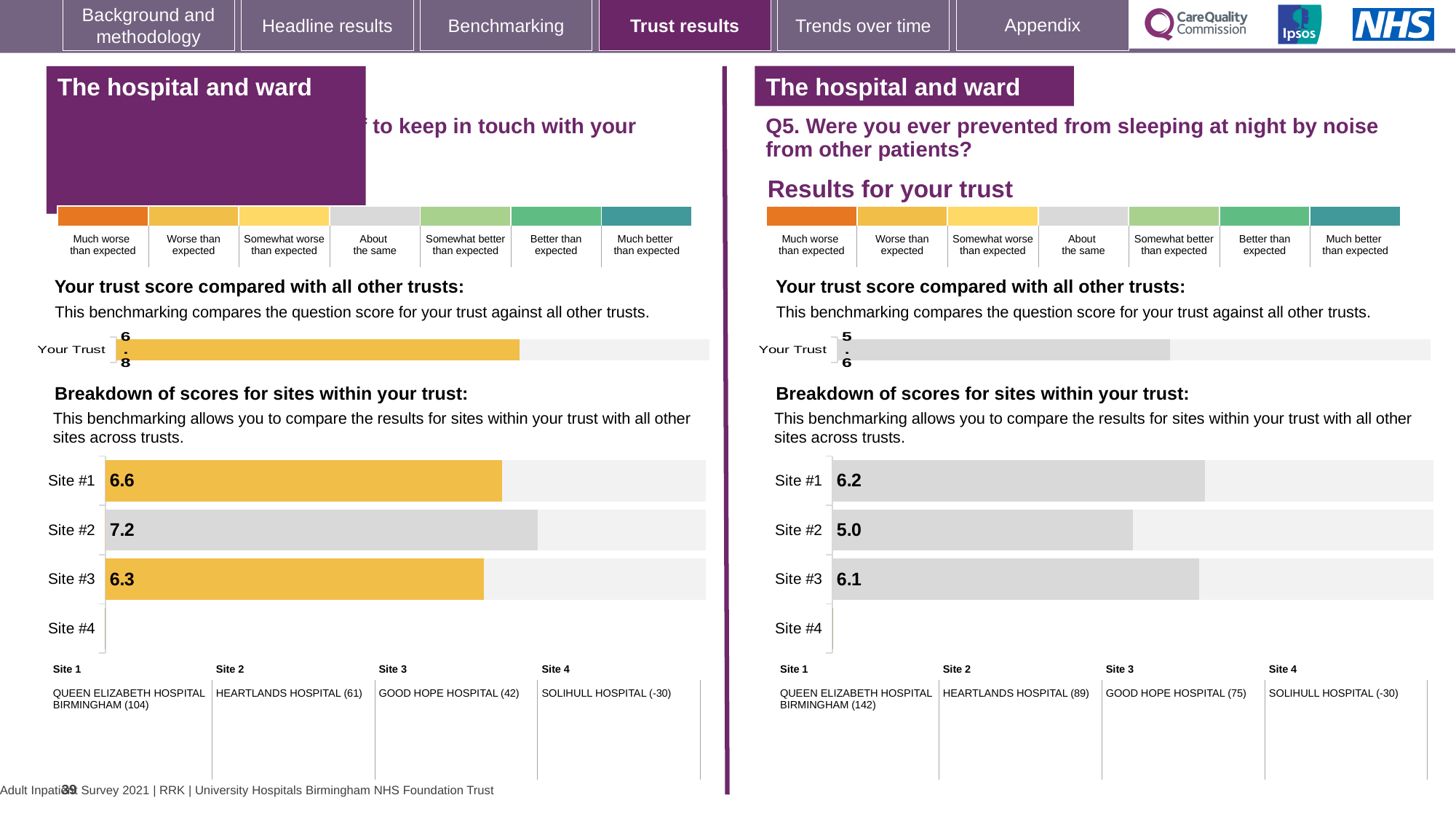
In the right-hand Q5 site breakdown chart, what is the difference between the scores for Site #1 and Site #2? 1.2 In the left-hand site breakdown chart, what is the difference between the scores for Site #2 and Site #3? 0.9 In the right-hand Q5 site breakdown chart, which has the larger score, Site #2 or Site #3? Site #3 In the right-hand Q5 site breakdown chart, which site has the highest score? Site #1 What type of chart is used for the breakdown of scores for sites on the right-hand side of the slide? Bar chart In the left-hand site breakdown chart, which site has the highest score? Site #2 In the left-hand site breakdown chart, which site has the lowest score? Site #3 In the right-hand Q5 'Your trust score compared with all other trusts' chart, what is the score for Your Trust? 5.6 In the right-hand chart for Q5 (prevented from sleeping at night by noise from other patients), what is the score for Site #2 in the breakdown of scores for sites? 5.0 In the right-hand Q5 site breakdown chart, which site has the lowest score? Site #2 In the left-hand site breakdown chart, what is the score for Site #2? 7.2 In the left-hand 'Your trust score compared with all other trusts' chart, what is the score for Your Trust? 6.8